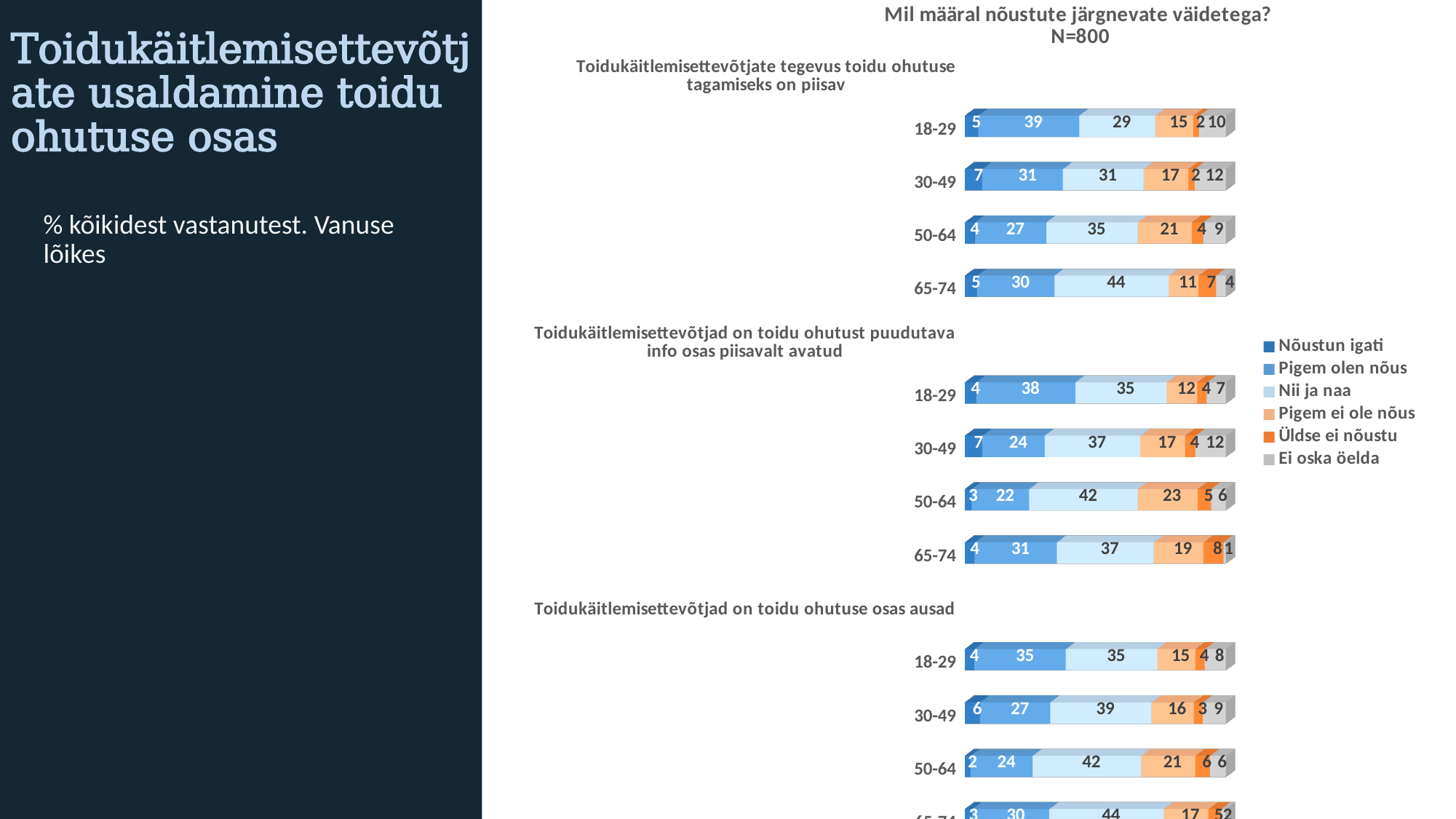
For the statement 'Toidukäitlemisettevõtjad on toidu ohutust puudutava info osas piisavalt avatud', which age group has the lowest 'Ei oska öelda' value? 65-74 For the statement 'Toidukäitlemisettevõtjad on toidu ohutuse osas ausad', which is larger for the 50-64 age group: 'Pigem olen nõus' or 'Nii ja naa'? Nii ja naa How many series does the legend list? 6 How many age groups are shown for the statement 'Toidukäitlemisettevõtjate tegevus toidu ohutuse tagamiseks on piisav'? 4 For the statement 'Toidukäitlemisettevõtjate tegevus toidu ohutuse tagamiseks on piisav', which age group has the highest 'Pigem olen nõus' value? 18-29 For the statement 'Toidukäitlemisettevõtjate tegevus toidu ohutuse tagamiseks on piisav', what is the 'Nii ja naa' value for the 65-74 age group? 44 What is the sample size (N) stated in the chart title? N=800 For the statement 'Toidukäitlemisettevõtjad on toidu ohutust puudutava info osas piisavalt avatud', what is the difference between the 'Nii ja naa' values of the 50-64 and 18-29 age groups? 7 For the statement 'Toidukäitlemisettevõtjate tegevus toidu ohutuse tagamiseks on piisav', what is the 'Pigem olen nõus' value for the 18-29 age group? 39 For the statement 'Toidukäitlemisettevõtjad on toidu ohutuse osas ausad', what is the 'Ei oska öelda' value for the 30-49 age group? 9 For the statement 'Toidukäitlemisettevõtjad on toidu ohutust puudutava info osas piisavalt avatud', what is the 'Pigem ei ole nõus' value for the 50-64 age group? 23 What type of chart is shown on the slide? Stacked bar chart